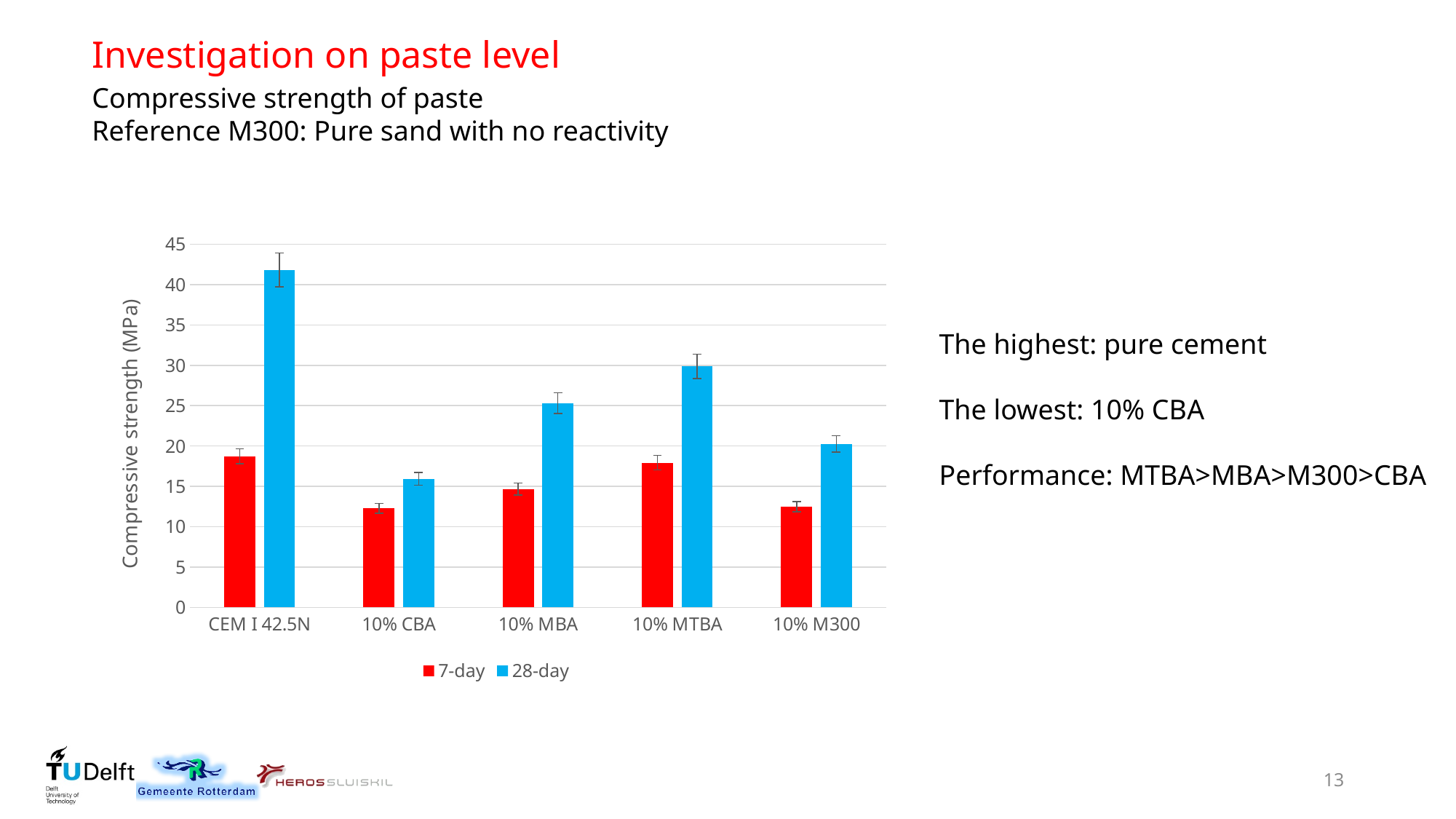
What is the label of the chart's vertical axis? Compressive strength (MPa) Which is larger: the 28-day value for 10% MBA or the 28-day value for 10% MTBA? 10% MTBA Which category has the highest 28-day compressive strength? CEM I 42.5N Is the 28-day value for CEM I 42.5N greater or less than 40? greater Is the 28-day value for 10% MBA greater or less than 20? greater Is the 7-day value for 10% M300 greater or less than 15? less How many categories are shown on the x axis of the chart? 5 Which is larger: the 28-day value for 10% M300 or the 28-day value for 10% CBA? 10% M300 What kind of chart is shown on the slide? bar chart Which category has the lowest 28-day compressive strength? 10% CBA How many series does the chart's legend list? 2